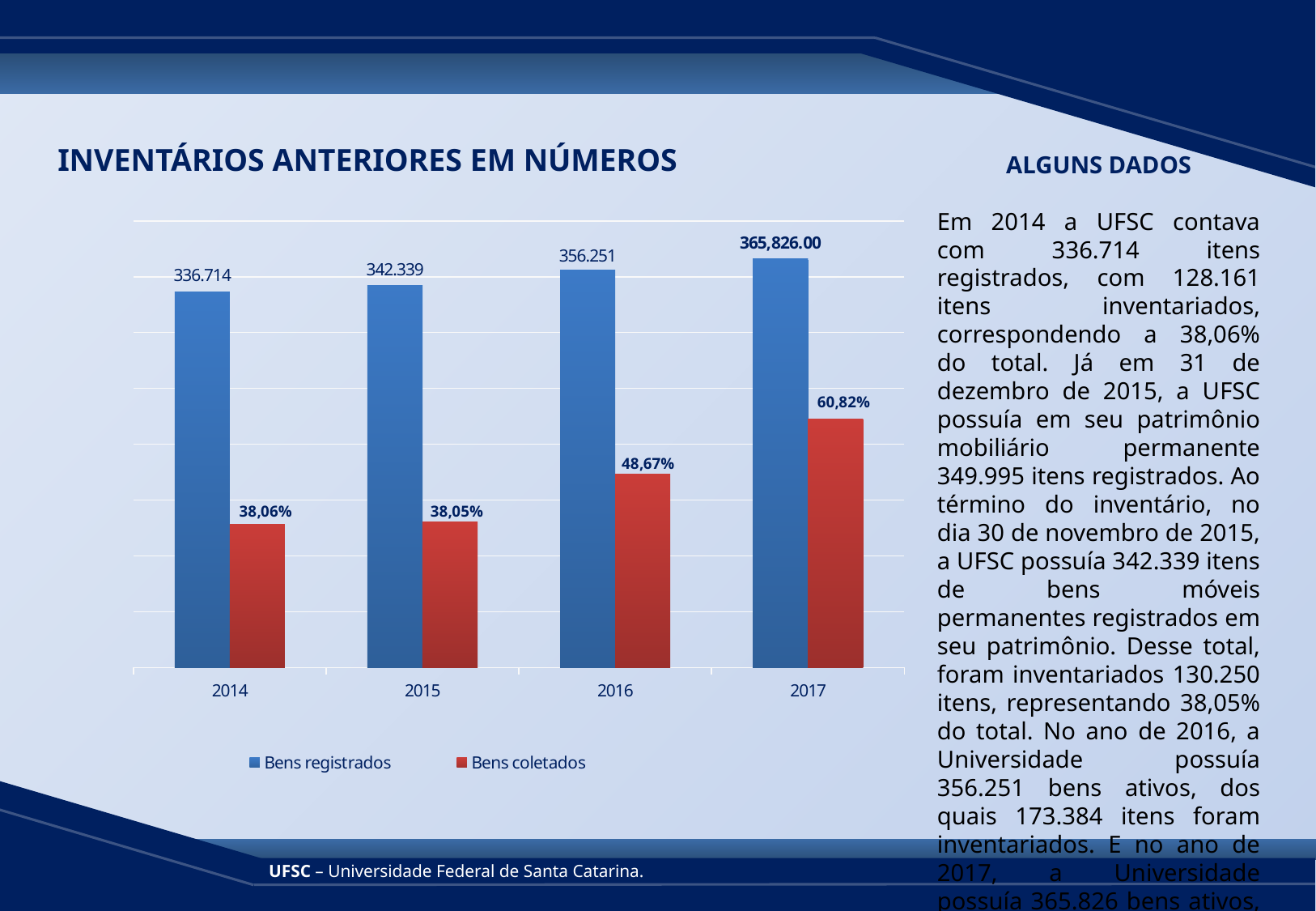
How many series does the legend list? 2 What is the difference between Bens coletados in 2017 and in 2014? 22,76% What kind of chart is shown on the slide? Bar chart What is the value of Bens coletados for 2015? 38,05% What is the difference between Bens registrados in 2016 and in 2015? 13.912 Which is larger, Bens coletados in 2016 or in 2015? 2016 How many years are shown on the x axis? 4 What is the value of Bens coletados for 2016? 48,67% What is the value of Bens registrados for 2014? 336.714 In which year is Bens coletados highest? 2017 What is the value of Bens registrados for 2017? 365,826.00 In which year is Bens registrados lowest? 2014